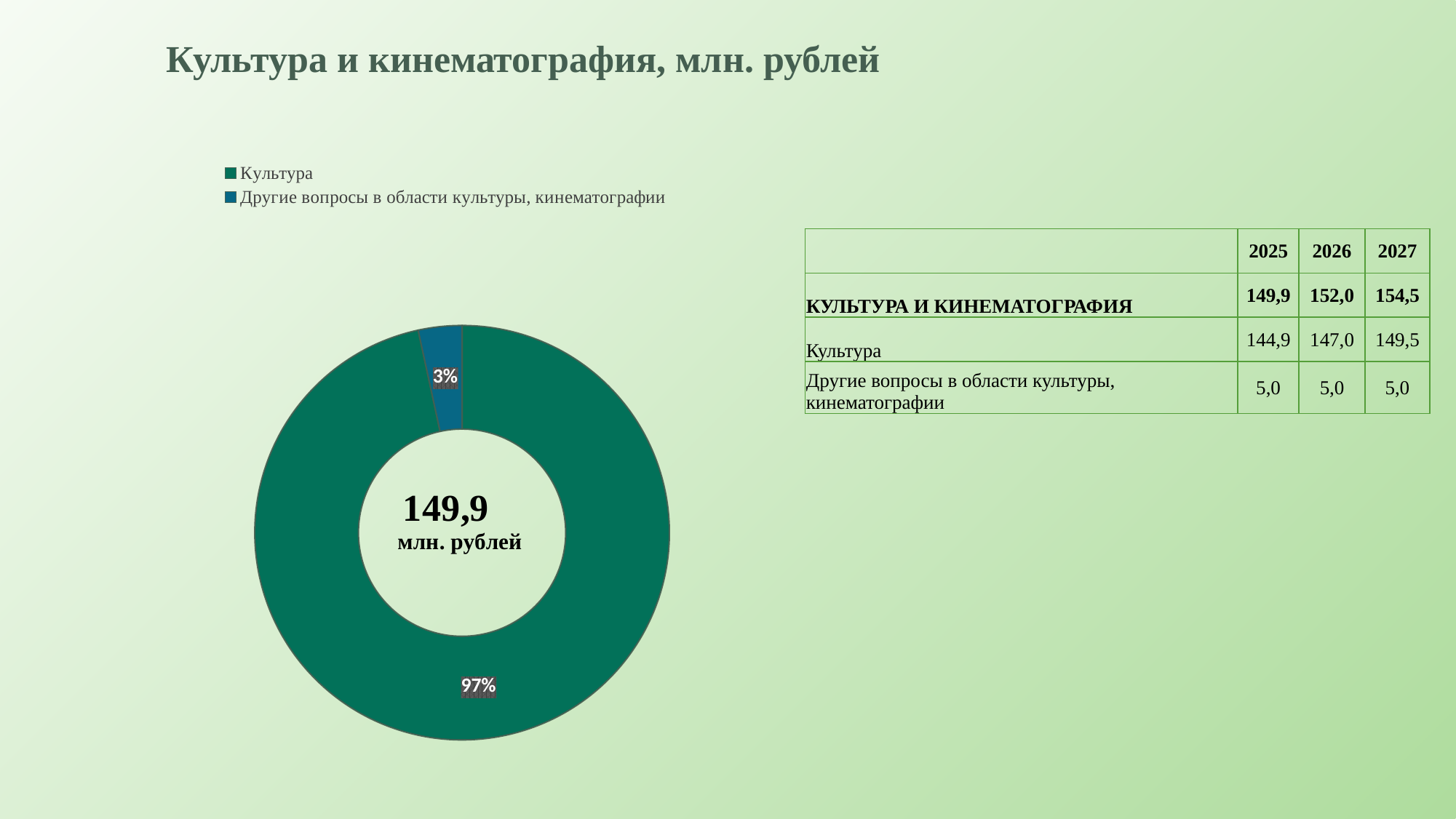
How many slices does the doughnut chart have? 2 Which category has the largest slice in the doughnut chart? Культура What share of the doughnut chart does the Культура slice represent? 97% How many entries does the chart legend list? 2 What total value is printed in the centre of the doughnut chart? 149,9 млн. рублей What is the title of the slide containing the doughnut chart? Культура и кинематография, млн. рублей Which slice is larger: Культура or Другие вопросы в области культуры, кинематографии? Культура What is the difference in percentage points between the Культура slice and the Другие вопросы в области культуры, кинематографии slice? 94 percentage points What share of the doughnut chart does the slice for Другие вопросы в области культуры, кинематографии represent? 3% Which category has the smallest slice in the doughnut chart? Другие вопросы в области культуры, кинематографии What kind of chart is shown on the slide? Doughnut (pie) chart